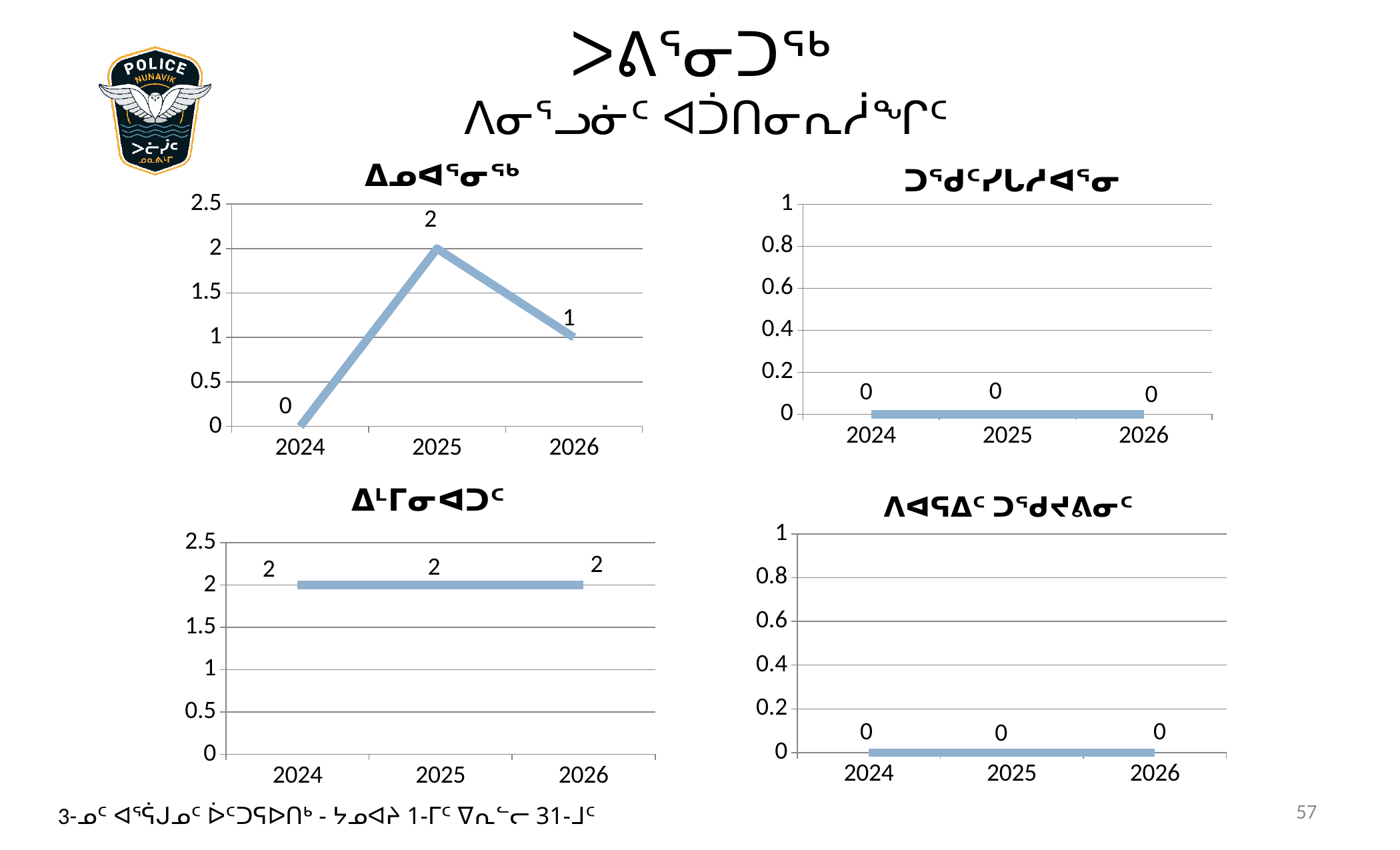
In the bottom-right chart, what is the value for 2026? 0 In the top-left chart, which is larger, the value for 2024 or the value for 2026? 2026 In the top-left chart, which year has the highest value? 2025 In the bottom-left chart, what is the value for 2024? 2 In the top-left chart, which year has the lowest value? 2024 What kind of chart is the top-left chart? line chart In the top-right chart, what is the value for 2025? 0 In the top-left chart, what is the difference between the values for 2025 and 2026? 1 In the bottom-left chart, do the values rise, fall or stay flat from 2024 to 2026? stay flat In the top-left chart, what is the value for 2025? 2 How many data points are plotted in the bottom-right chart? 3 In the top-left chart, what is the value for 2026? 1